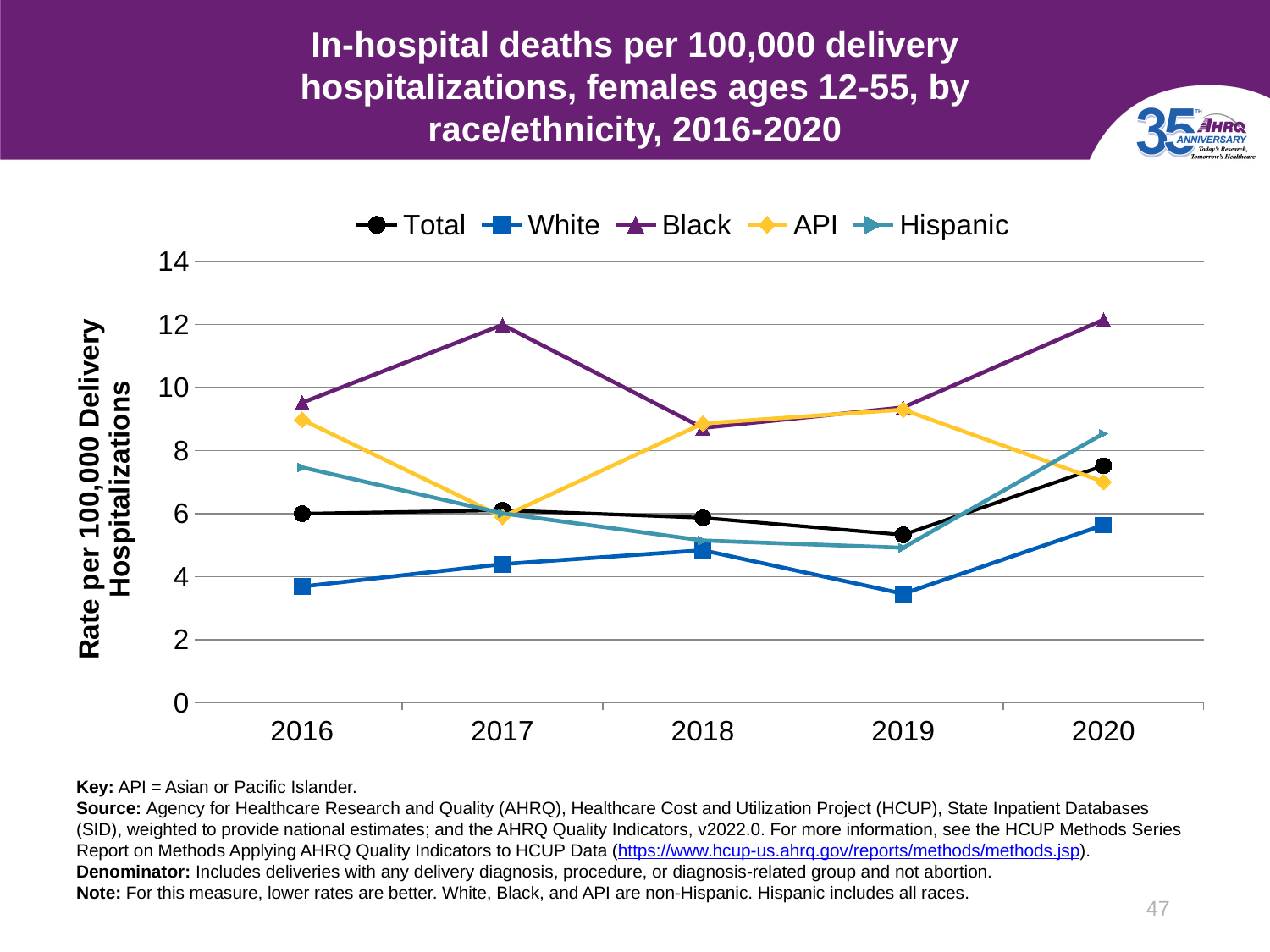
In 2020, which is larger, the Total rate or the Hispanic rate? Hispanic Is the value for Black in 2017 greater or less than 10? greater In 2018, which is larger, the API rate or the Hispanic rate? API What kind of chart is shown on the slide? line chart What is the title of the y axis? Rate per 100,000 Delivery Hospitalizations How many series does the legend list? 5 Is the value for Hispanic in 2020 greater or less than 8? greater How many years are plotted along the x axis? 5 Which race/ethnicity group has the lowest rate in 2019? White Is the value for White in 2016 greater or less than 4? less Does the White rate rise or fall from 2019 to 2020? rise Which race/ethnicity group has the highest rate in 2020? Black